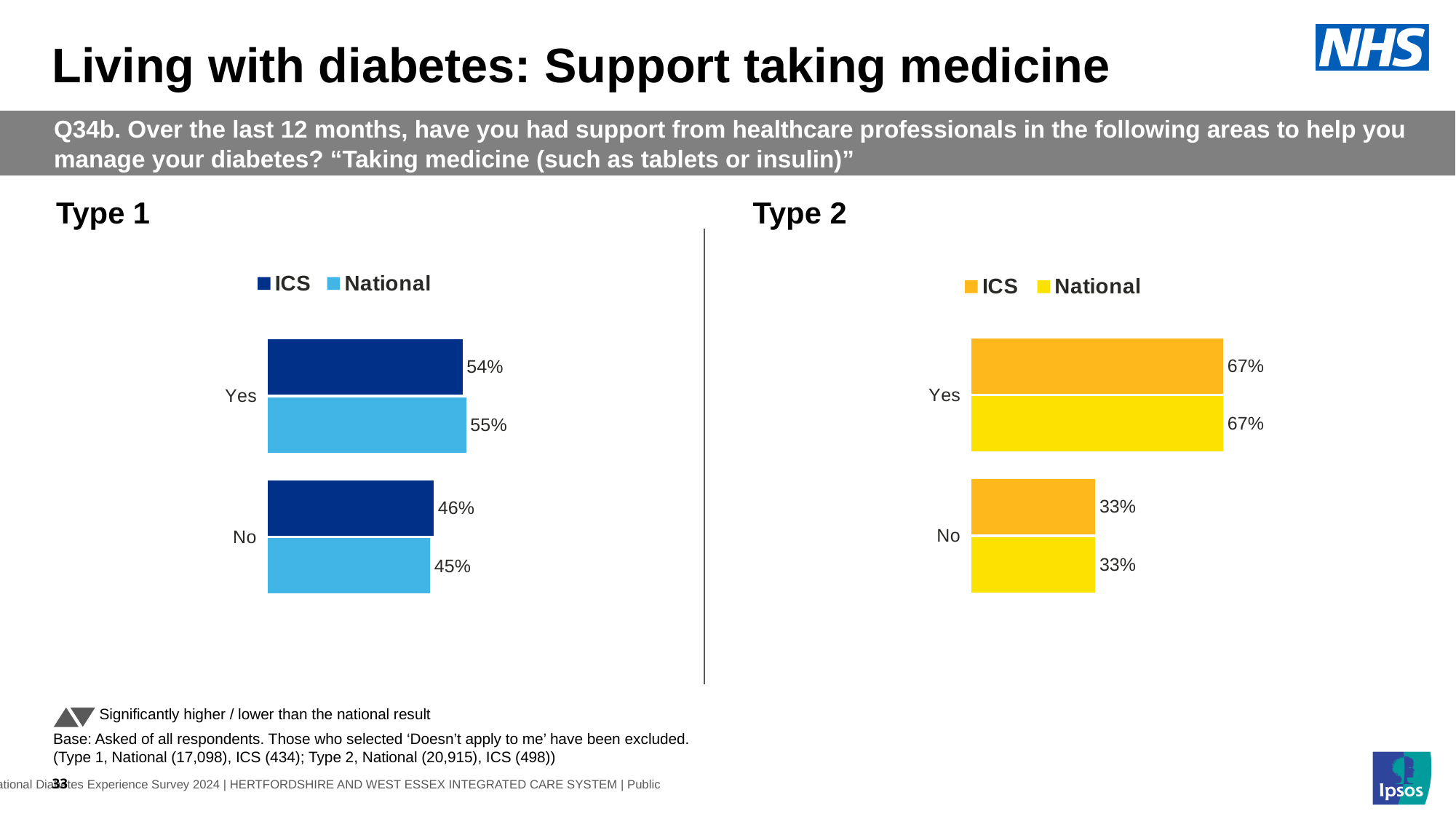
In the Type 2 chart, is the ICS value for Yes larger or smaller than the ICS value for No? larger In the Type 1 chart, what is the National value for No? 45% How many series does the legend of the Type 2 chart list? 2 In the Type 1 chart, what is the ICS value for Yes? 54% In the Type 2 chart, what is the difference between the ICS values for Yes and No? 34 percentage points What kind of chart is the Type 1 chart? bar chart In the Type 2 chart, what is the ICS value for Yes? 67% In the Type 2 chart, what is the National value for No? 33% In the Type 1 chart, which category has the lowest National value? No In the Type 2 chart, which category has the highest ICS value? Yes In the Type 1 chart, what is the difference between the ICS and National values for Yes? 1 percentage point How many categories are shown in the Type 1 chart? 2